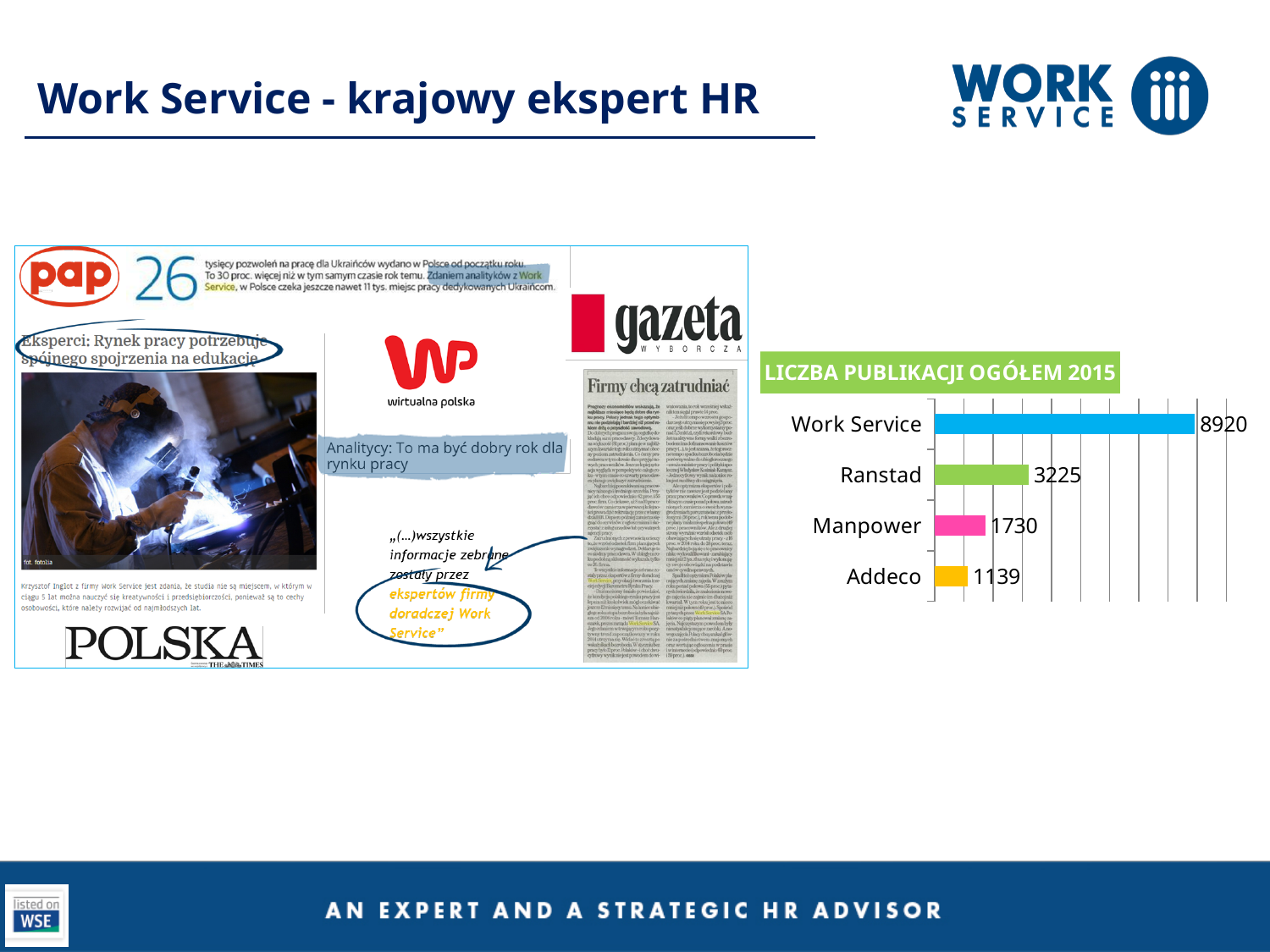
Which category has the highest value in the chart? Work Service What is the difference between the values for Work Service and Ranstad? 5695 What is the value for Ranstad in the chart? 3225 Which category has the lowest value in the chart? Addeco What is the value for Work Service in the chart? 8920 What is the value for Addeco in the chart? 1139 What kind of chart is shown on the slide? Bar chart How many categories are shown in the chart? 4 What is the title of the chart? LICZBA PUBLIKACJI OGÓŁEM 2015 What is the difference between the values for Manpower and Addeco? 591 Which is larger, the value for Ranstad or the value for Manpower? Ranstad What is the value for Manpower in the chart? 1730